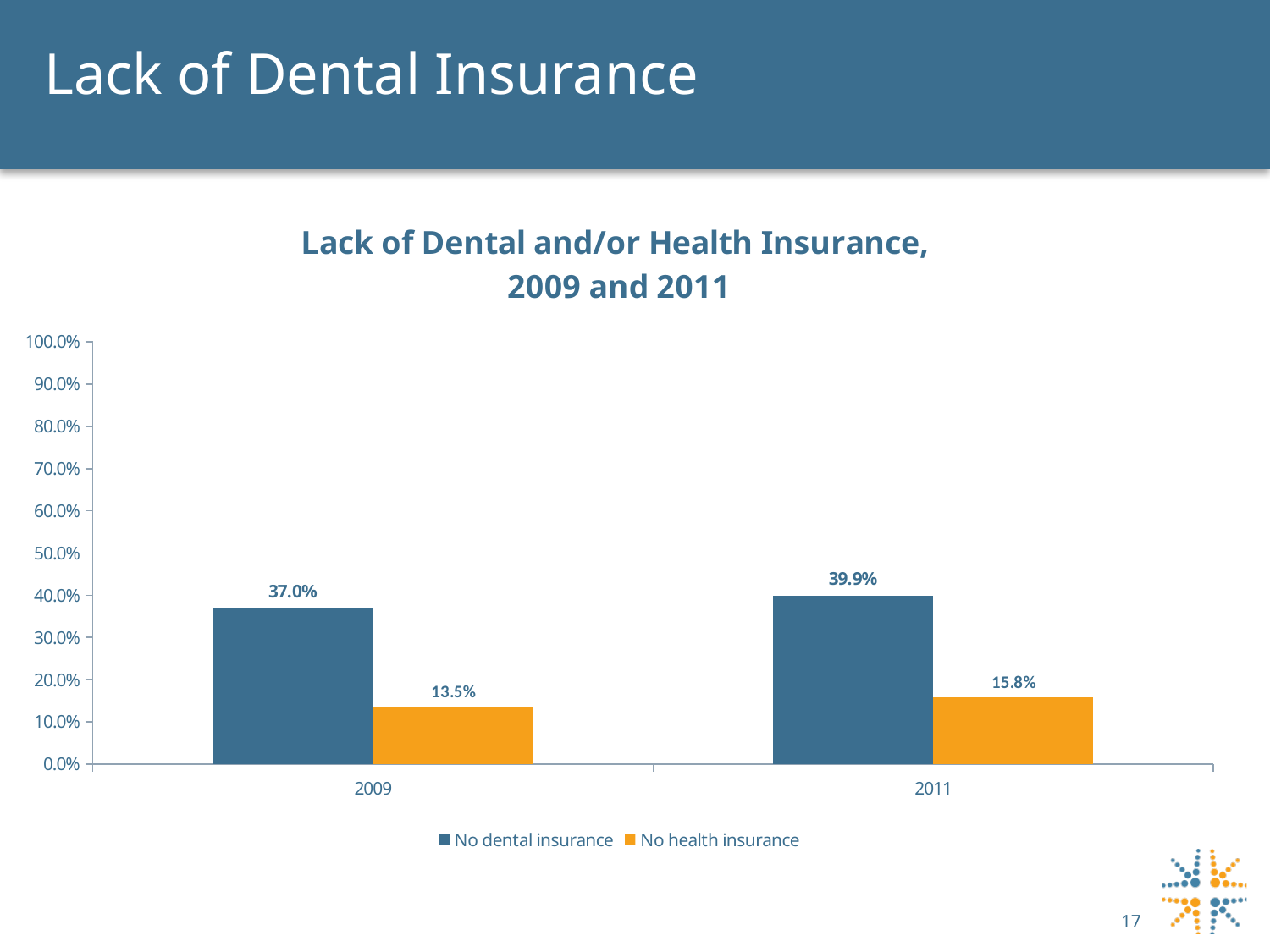
Which year has the higher value for No dental insurance? 2011 What kind of chart is shown on the slide? Bar chart By how much did No health insurance change from 2009 to 2011? 2.3% What is the value for No dental insurance in 2009? 37.0% What is the value for No health insurance in 2009? 13.5% How many years are shown on the x axis? 2 What is the value for No dental insurance in 2011? 39.9% Which series has the lowest value in 2009? No health insurance How many series does the legend list? 2 What is the difference between No dental insurance and No health insurance in 2011? 24.1% Is the value for No dental insurance in 2011 greater or less than 40.0%? less What is the value for No health insurance in 2011? 15.8%